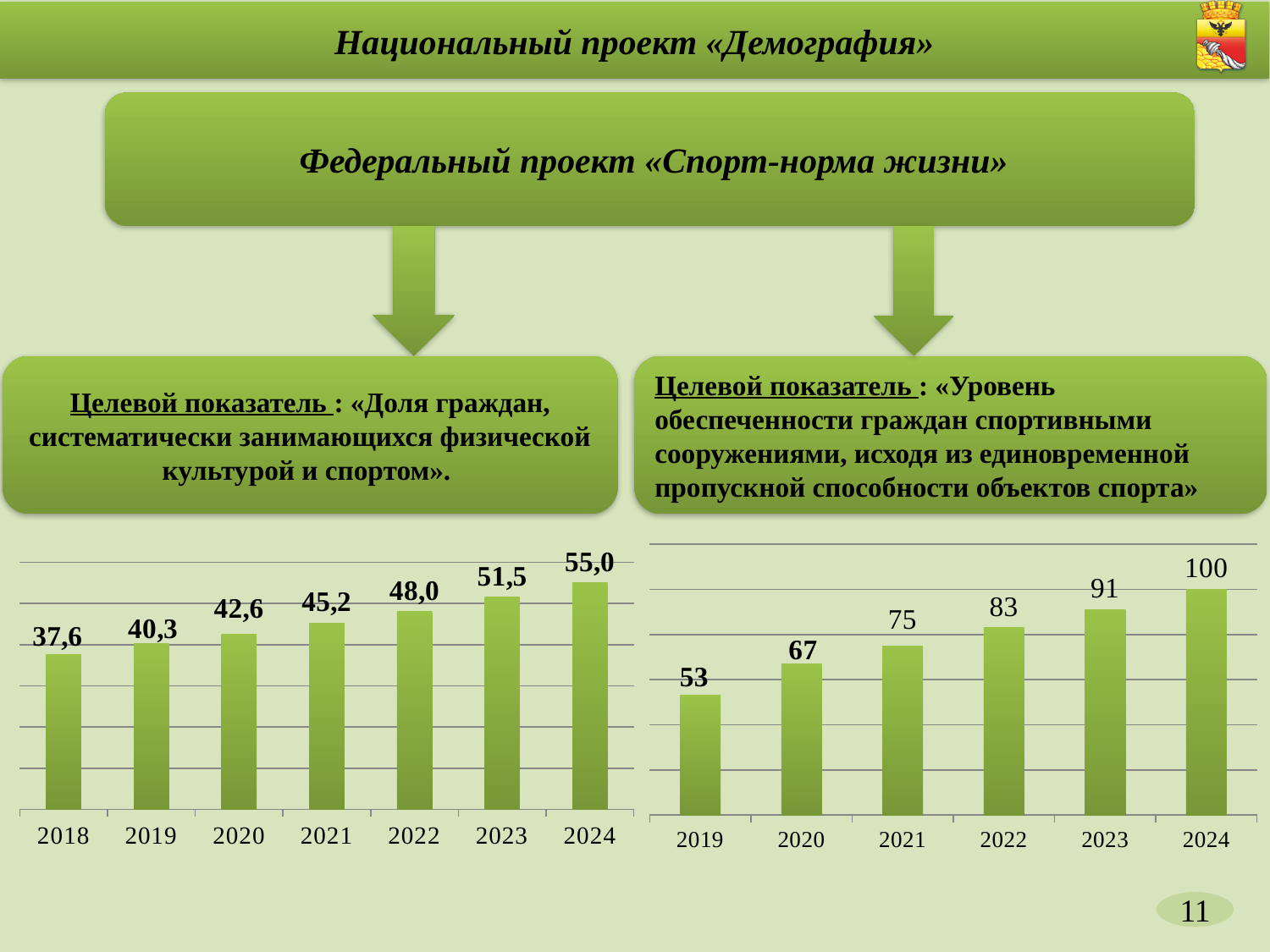
In the left chart, what is the difference between the values for 2024 and 2018? 17,4 How many years are shown on the x axis of the left chart? 7 In the right chart, what is the difference between the values for 2024 and 2019? 47 How many years are shown on the x axis of the right chart? 6 In the right chart (level of provision of citizens with sports facilities), what is the value for 2021? 75 In the right chart, which is larger: the value for 2020 or the value for 2022? 2022 In the left chart, what is the value for 2022? 48,0 What kind of chart is the right chart? bar chart In the left chart (share of citizens systematically engaged in physical culture and sport), what is the value for 2018? 37,6 In the left chart, do the values rise or fall from 2018 to 2024? rise In the left chart, which year has the lowest value? 2018 In the right chart, which year has the highest value? 2024